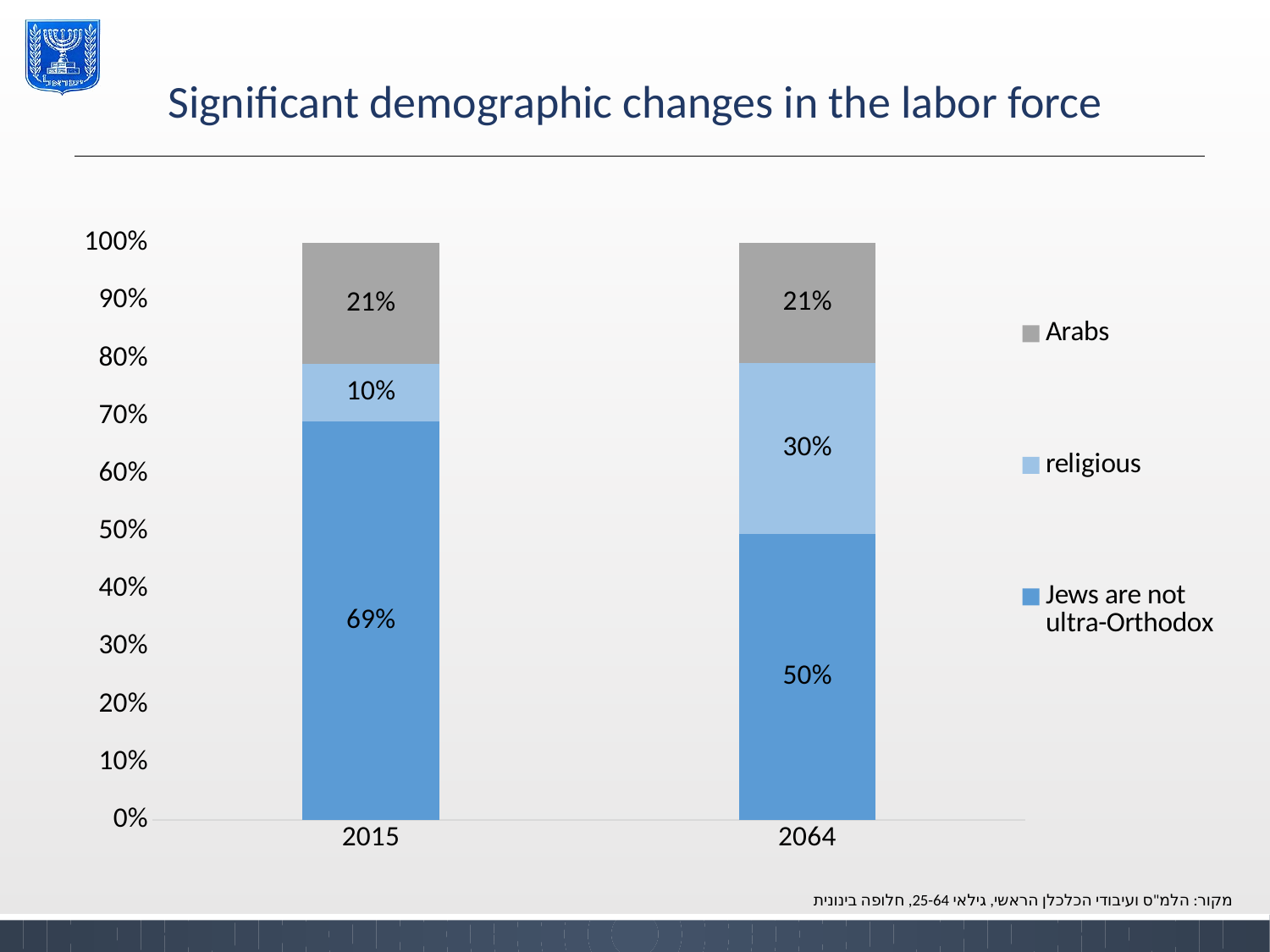
What is the value for religious in 2064? 30% What is the value for religious in 2015? 10% What is the value for Arabs in 2015? 21% Is the share of Jews are not ultra-Orthodox larger in 2015 or in 2064? 2015 What kind of chart is shown on the slide? Stacked bar chart Which series has the smallest share in 2015? religious How many series does the legend list? 3 What is the value for Jews are not ultra-Orthodox in 2064? 50% Which series has the largest share in 2064? Jews are not ultra-Orthodox By how many percentage points does the religious share change from 2015 to 2064? 20% How many categories are shown on the x axis? 2 What is the value for Jews are not ultra-Orthodox in 2015? 69%